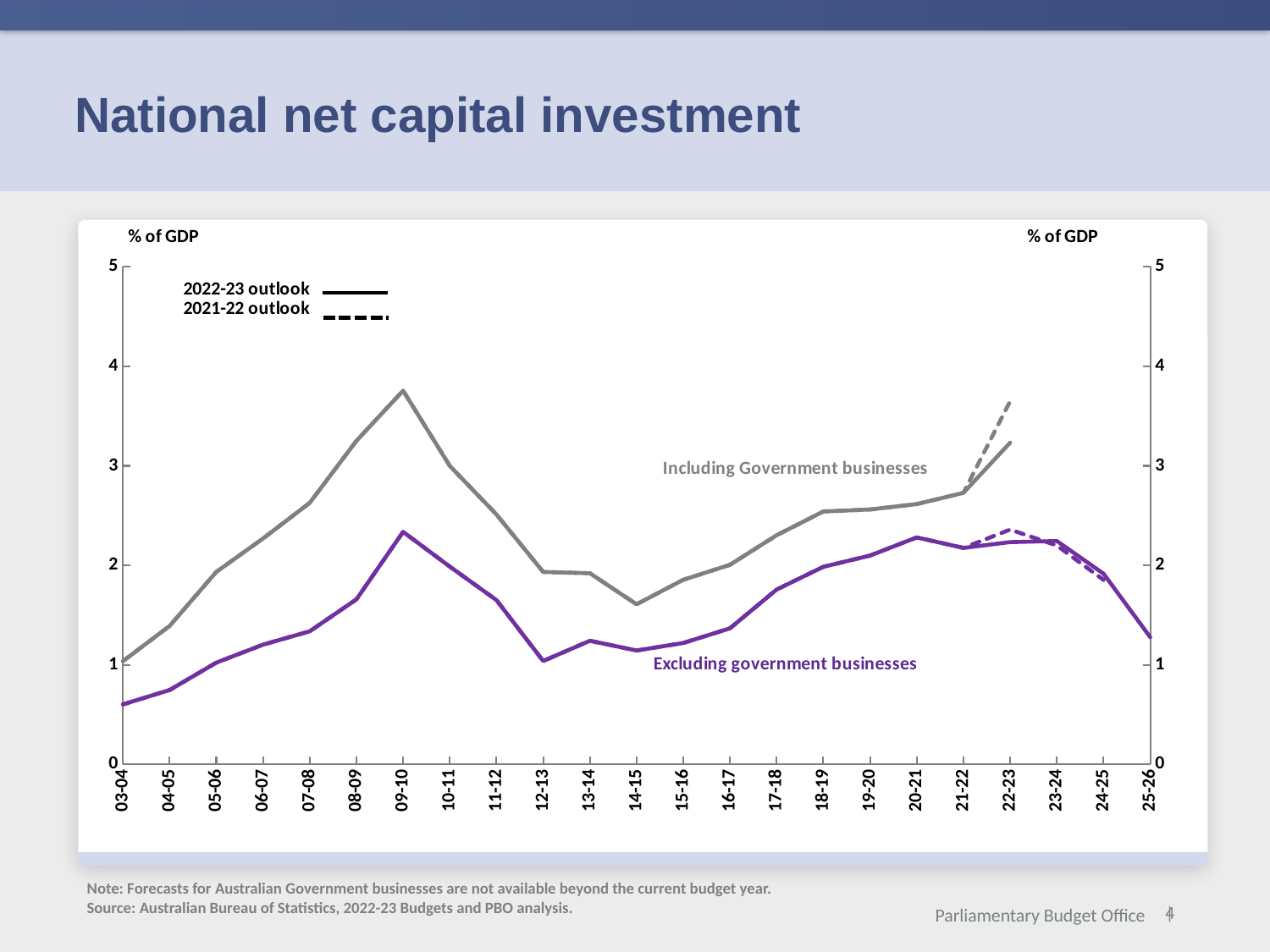
Is the value for 'Excluding government businesses' in 03-04 greater or less than 1? less In which year does the 'Excluding government businesses' line reach its highest value? 09-10 What kind of chart is shown on the slide? line chart In which year is the 'Excluding government businesses' line at its lowest value? 03-04 Is the value for 'Including Government businesses' in 09-10 greater or less than 3? greater In 09-10, which line is higher: 'Including Government businesses' or 'Excluding government businesses'? Including Government businesses Does the 'Including Government businesses' line rise or fall between 09-10 and 14-15? fall How many entries does the legend list? 2 How many financial years are shown along the x axis? 23 Is the value for 'Including Government businesses' in 14-15 greater or less than 2? less In which year does the 'Including Government businesses' line reach its highest value? 09-10 What unit is shown on the vertical axis label? % of GDP